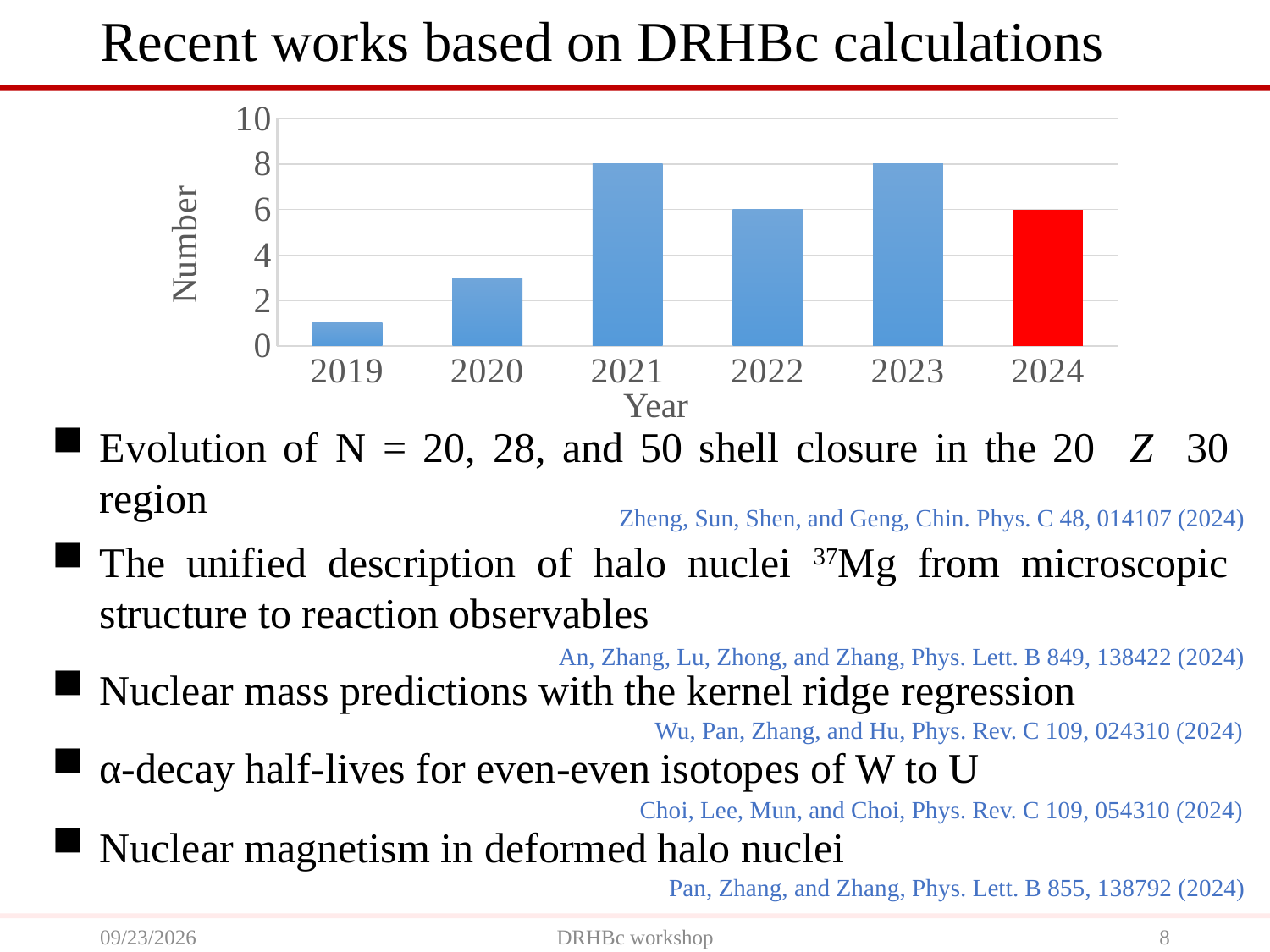
Is the value for 2020 greater or less than 4? less What kind of chart is shown on the slide? bar chart What is the value for 2023 in the chart? 8 What is the difference between the values for 2021 and 2022? 2 How many years are shown on the x axis of the chart? 6 What is the value for 2021 in the chart? 8 What is the value for 2022 in the chart? 6 Which year's bar is coloured red in the chart? 2024 What is the value for 2024 in the chart? 6 Is the value for 2019 greater or less than 2? less Which year has the lowest value in the chart? 2019 Which is larger, the value for 2023 or the value for 2024? 2023